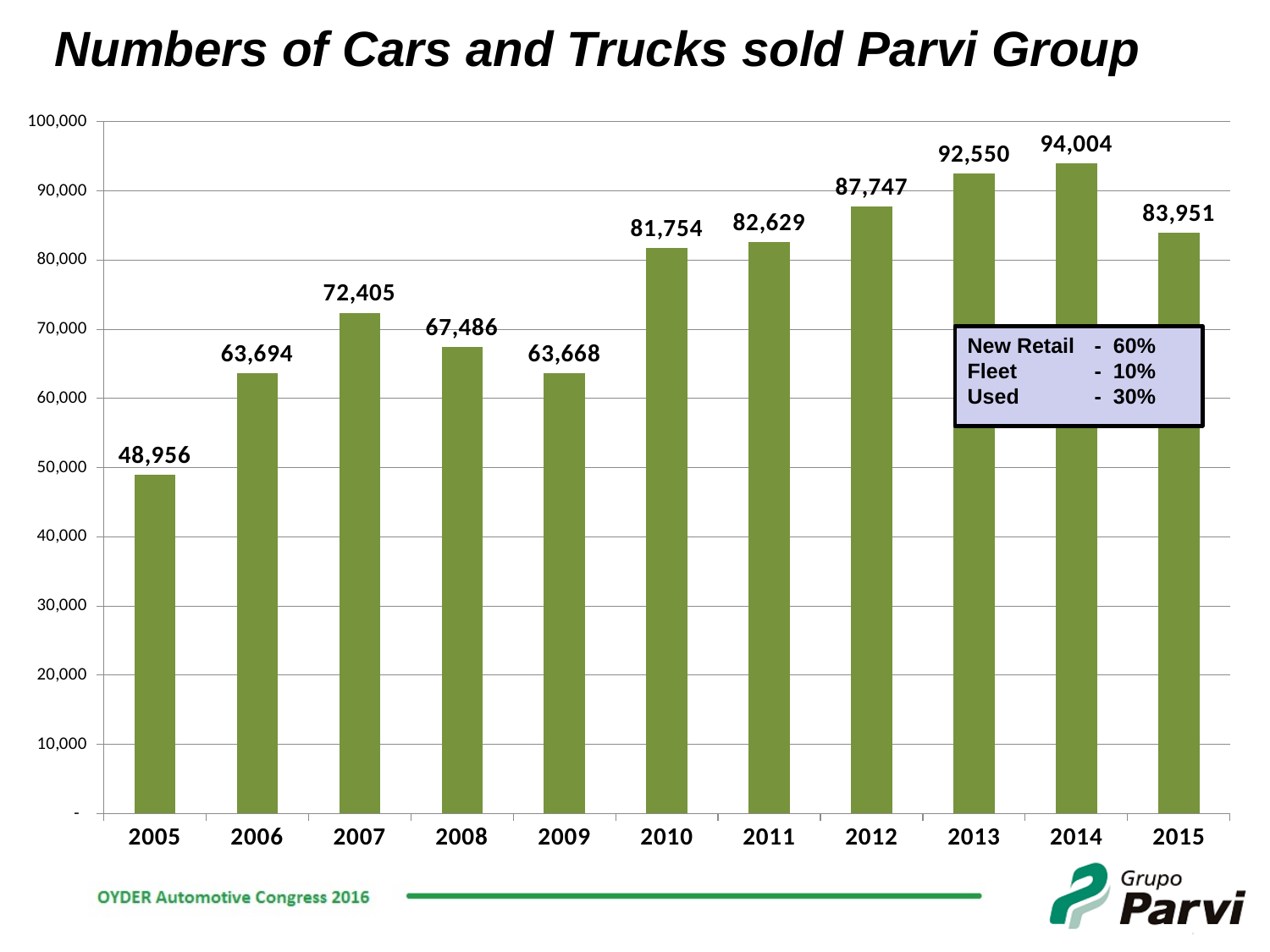
Which year has the lowest number of cars and trucks sold? 2005 How many years are shown on the x axis? 11 What is the difference between the values for 2014 and 2015? 10,053 What value is shown for 2012? 87,747 According to the box on the chart, what percentage of sales is Used? 30% Is the value for 2013 greater or less than 90,000? greater What is the difference between the values for 2010 and 2009? 18,086 What value is shown for 2015? 83,951 What kind of chart is shown on the slide? Bar chart Which year has the highest number of cars and trucks sold? 2014 What was the number of cars and trucks sold by Parvi Group in 2005? 48,956 Which year has the larger value, 2007 or 2008? 2007